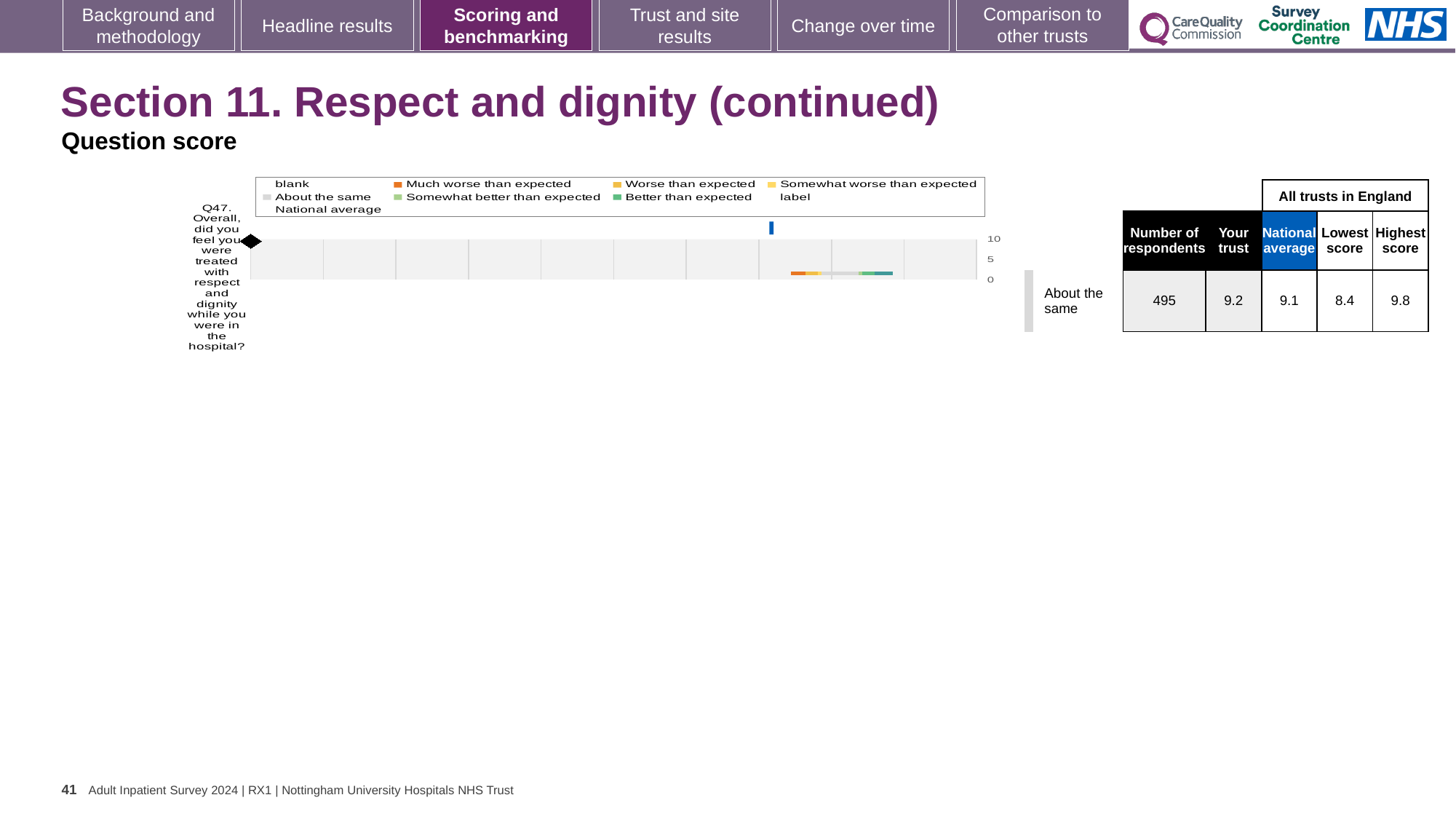
In the table beside the chart, what is the 'Your trust' score for Q47? 9.2 In the table beside the chart, what is the Highest score among all trusts in England for Q47? 9.8 What kind of chart is shown on the slide for Q47? bar chart In the table beside the chart, what is the National average score for Q47? 9.1 For Q47, which is larger: the 'Your trust' score or the National average? Your trust What benchmark category label is shown next to the chart for the trust's Q47 result? About the same How many entries does the chart legend list? 9 In the table beside the chart, what is the Lowest score among all trusts in England for Q47? 8.4 In the table beside the chart, what is the Number of respondents for Q47? 495 What is the highest tick value shown on the chart's axis? 10 For Q47, what is the difference between the Highest score and the Lowest score among all trusts in England? 1.4 Which question number is the chart about? Q47